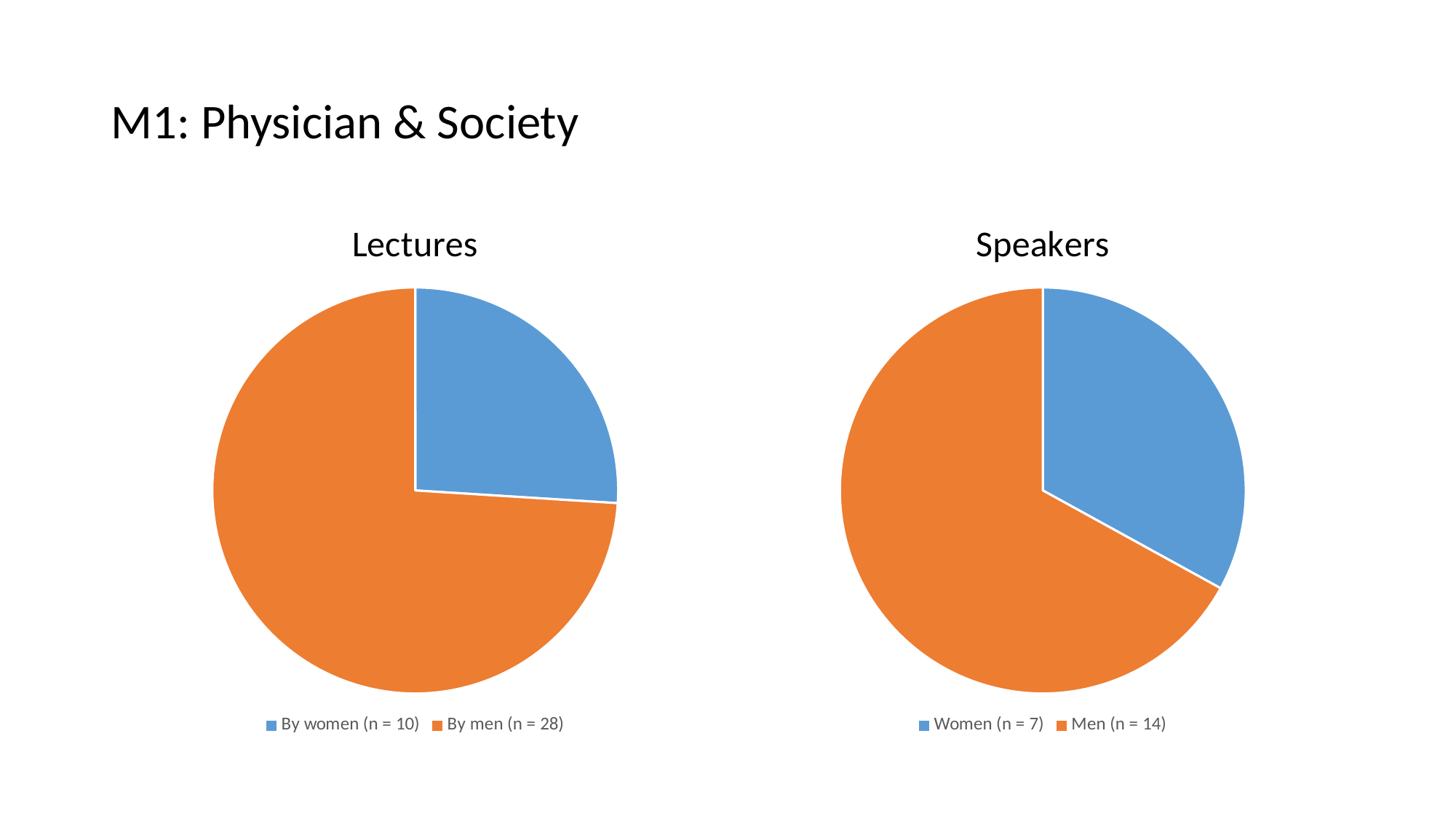
In the Speakers chart, how many speakers were men? 14 In the Lectures chart, what is the total number of lectures across both slices? 38 In the Speakers chart, what is the total number of speakers across both slices? 21 In the Lectures chart, how many lectures were given by women? 10 In the Lectures chart, which slice is the largest? By men (n = 28) In the Lectures chart, how many lectures were given by men? 28 In the Speakers chart, what is the difference between the number of men and women speakers? 7 In the Speakers chart, how many speakers were women? 7 What type of chart is the Speakers chart? Pie chart In the Lectures chart, what colour is the slice for lectures by women? Blue In the Lectures chart, what is the difference between the number of lectures by men and by women? 18 In the Speakers chart, which slice is the smallest? Women (n = 7)